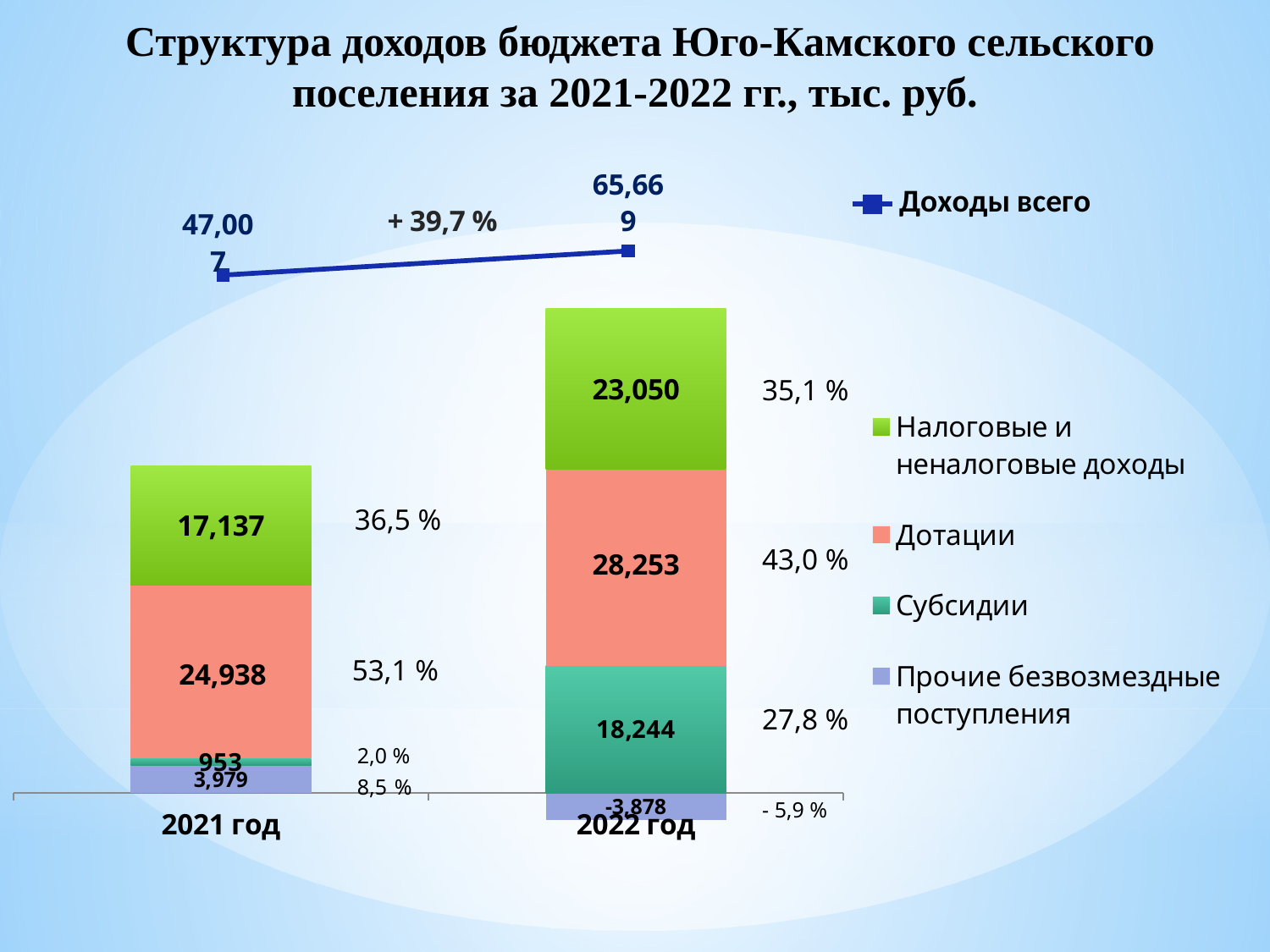
What percentage change in Доходы всего is shown between 2021 год and 2022 год? + 39,7 % What percentage share is shown for Дотации in 2021 год? 53,1 % Which is larger: Субсидии in 2021 год or Субсидии in 2022 год? 2022 год Which component has the smallest value in 2021 год? Субсидии What is the value of Доходы всего for 2021 год? 47,007 How many entries does the legend list? 5 Which component has the largest value in 2022 год? Дотации What is the difference between Налоговые и неналоговые доходы in 2022 год and in 2021 год? 5,913 What is the value of Субсидии for 2022 год? 18,244 What is the value of Дотации for 2021 год? 24,938 What is the value of Налоговые и неналоговые доходы for 2022 год? 23,050 What is the value of Прочие безвозмездные поступления for 2022 год? -3,878